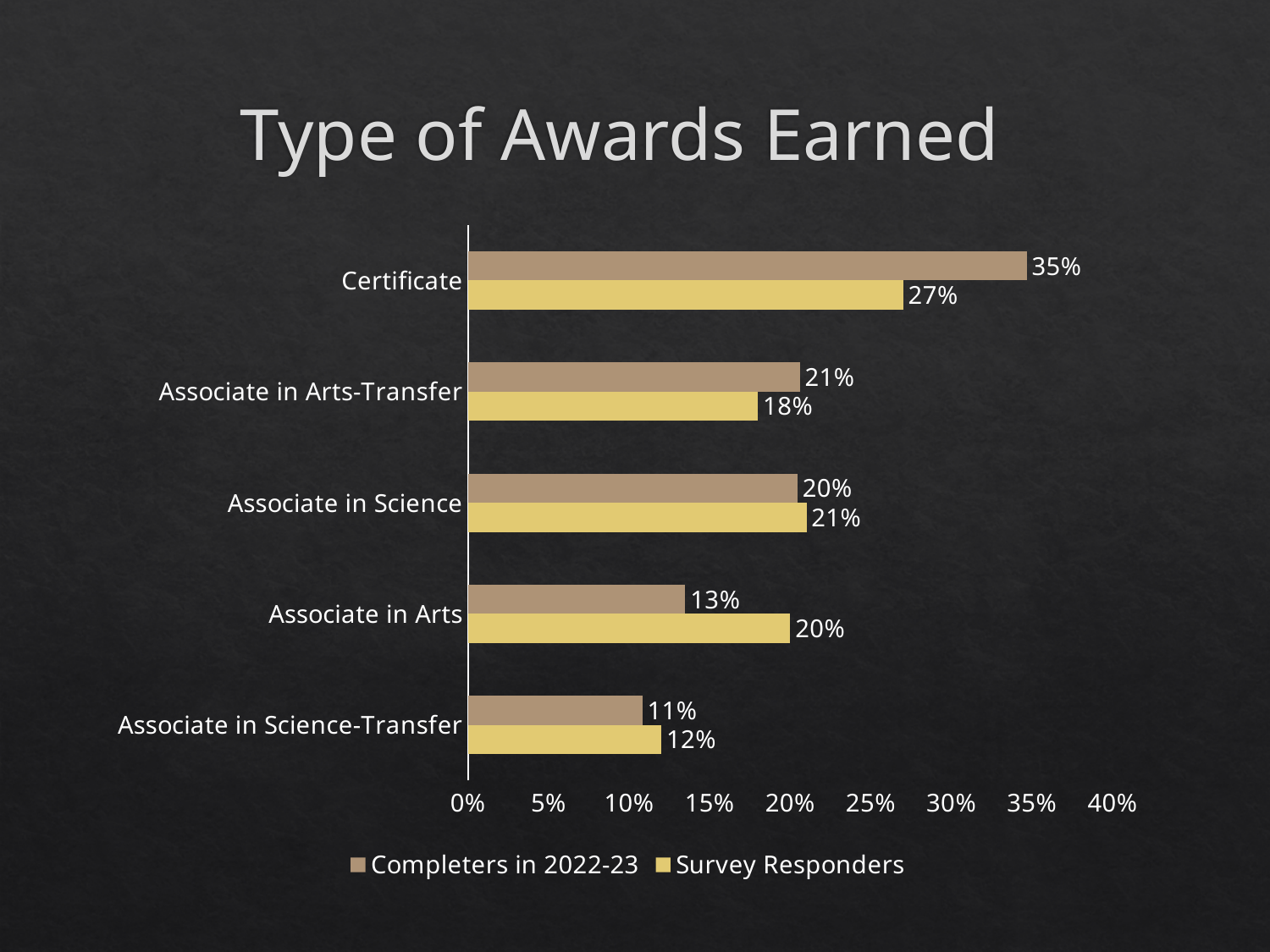
How many categories are shown on the chart? 5 Which category has the highest value in the Survey Responders series? Certificate What is the difference between the Survey Responders and Completers in 2022-23 values for Associate in Arts? 7% What kind of chart is shown on the slide? Bar chart How many series does the legend list? 2 What is the title of the chart? Type of Awards Earned Which category has the lowest value in the Completers in 2022-23 series? Associate in Science-Transfer What is the value for Associate in Science-Transfer in the Completers in 2022-23 series? 11% For Associate in Arts-Transfer, which series has the larger value: Completers in 2022-23 or Survey Responders? Completers in 2022-23 What is the value for Certificate in the Completers in 2022-23 series? 35% What is the value for Associate in Arts in the Survey Responders series? 20% What is the difference between the Completers in 2022-23 and Survey Responders values for Certificate? 8%